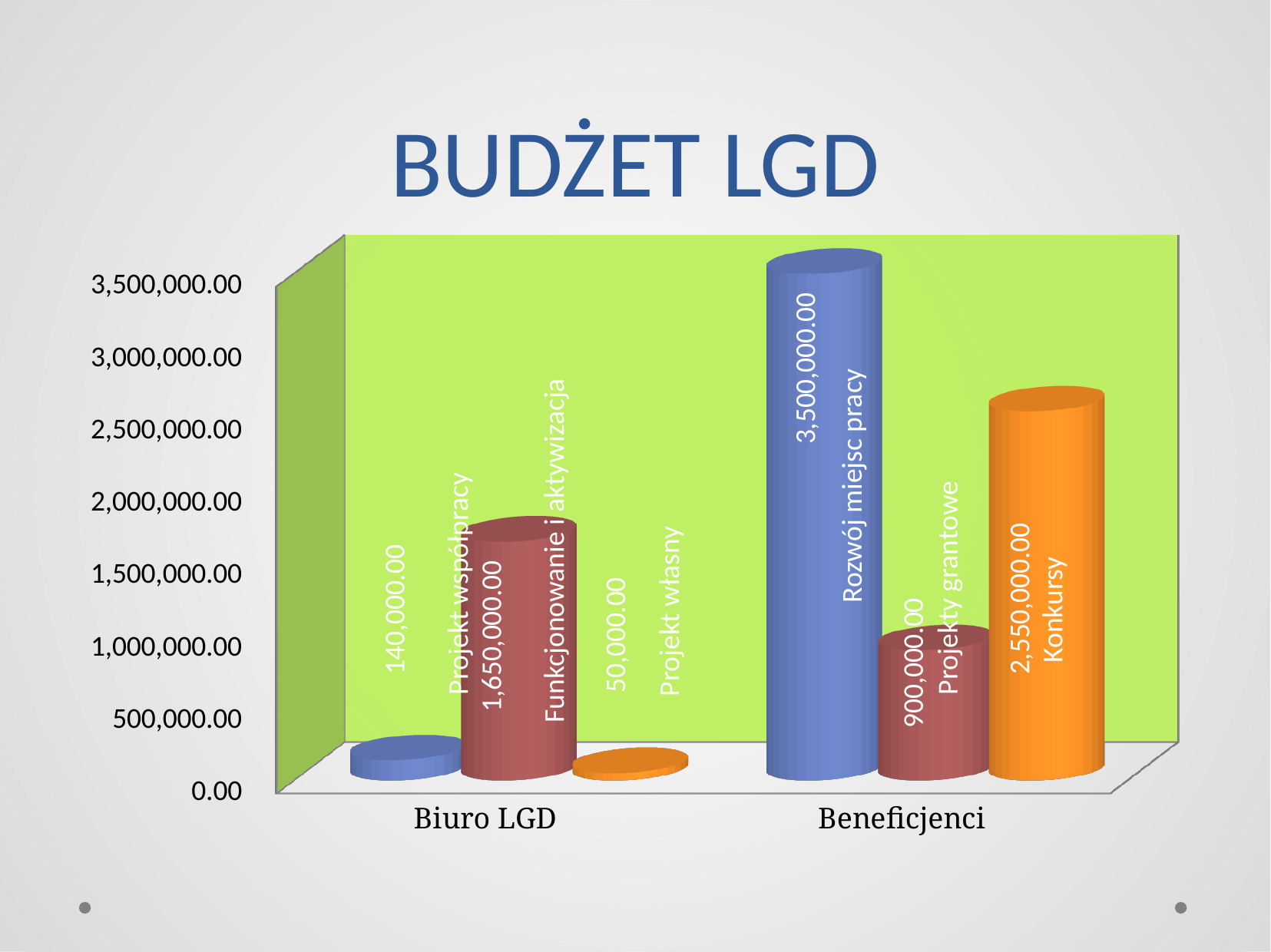
What is the value for Projekt współpracy under Biuro LGD? 140,000.00 What is the value for Konkursy under Beneficjenci? 2,550,000.00 What is the value for Projekt własny under Biuro LGD? 50,000.00 What is the difference between Rozwój miejsc pracy and Konkursy? 950,000.00 Which bar has the lowest value on the chart? Projekt własny What is the title of the chart? BUDŻET LGD What is the value for Rozwój miejsc pracy under Beneficjenci? 3,500,000.00 How many categories are shown on the x axis? 2 Which bar has the highest value on the chart? Rozwój miejsc pracy What is the value for Funkcjonowanie i aktywizacja under Biuro LGD? 1,650,000.00 What kind of chart is shown on the slide? Bar chart Which is larger: Funkcjonowanie i aktywizacja or Projekty grantowe? Funkcjonowanie i aktywizacja